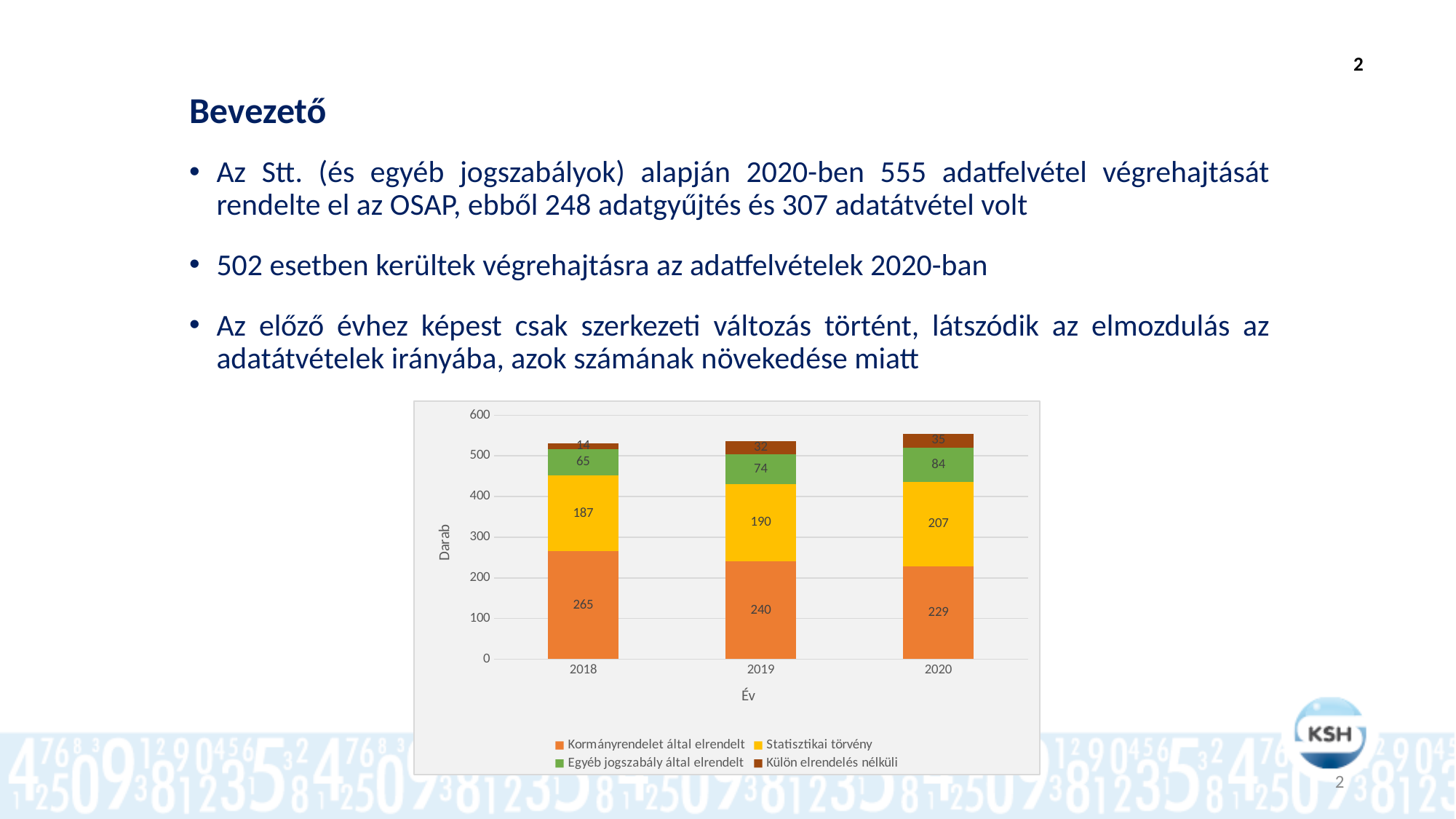
What is the value for Kormányrendelet által elrendelt in 2018? 265 What kind of chart is shown on the slide? stacked bar chart In which year is the value for Kormányrendelet által elrendelt the highest? 2018 What is the total of the stacked bar for 2020? 555 What is the value for Külön elrendelés nélküli in 2019? 32 How many years are shown on the x axis of the chart? 3 How many series does the chart legend list? 4 In which year is the value for Külön elrendelés nélküli the lowest? 2018 What is the value for Egyéb jogszabály által elrendelt in 2020? 84 Does the value for Egyéb jogszabály által elrendelt rise or fall from 2018 to 2020? rise What is the difference between the Statisztikai törvény values for 2020 and 2018? 20 What is the value for Statisztikai törvény in 2020? 207